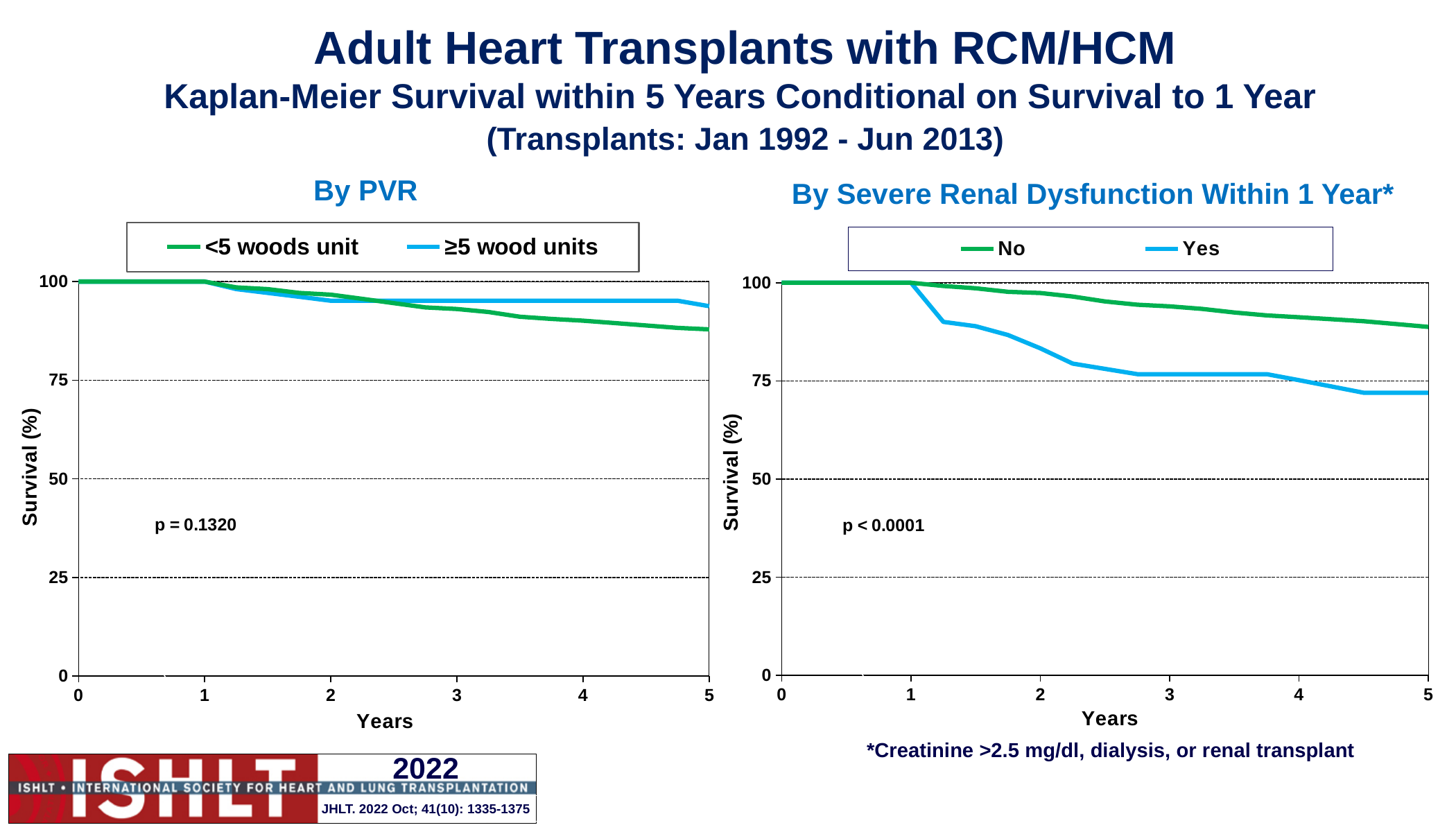
In the 'By PVR' chart, is the survival for '<5 woods unit' at year 5 greater or less than 75? greater In the 'By Severe Renal Dysfunction Within 1 Year*' chart, is the survival for 'No' at year 5 greater or less than 75? greater What kind of chart is the 'By PVR' chart? line chart In the 'By Severe Renal Dysfunction Within 1 Year*' chart, is the survival for 'Yes' at year 5 greater or less than 75? less How many series does the legend of the 'By Severe Renal Dysfunction Within 1 Year*' chart list? 2 In the 'By Severe Renal Dysfunction Within 1 Year*' chart, does survival for 'Yes' rise or fall from year 1 to year 5? fall How many series does the legend of the 'By PVR' chart list? 2 In the 'By Severe Renal Dysfunction Within 1 Year*' chart, at year 5, which series has the higher survival: 'No' or 'Yes'? No In the 'By PVR' chart, does survival for '<5 woods unit' rise or fall from year 1 to year 5? fall What p-value is printed on the 'By PVR' chart? p = 0.1320 What p-value is printed on the 'By Severe Renal Dysfunction Within 1 Year*' chart? p < 0.0001 In the 'By PVR' chart, at year 5, which series has the higher survival: '<5 woods unit' or '≥5 wood units'? ≥5 wood units